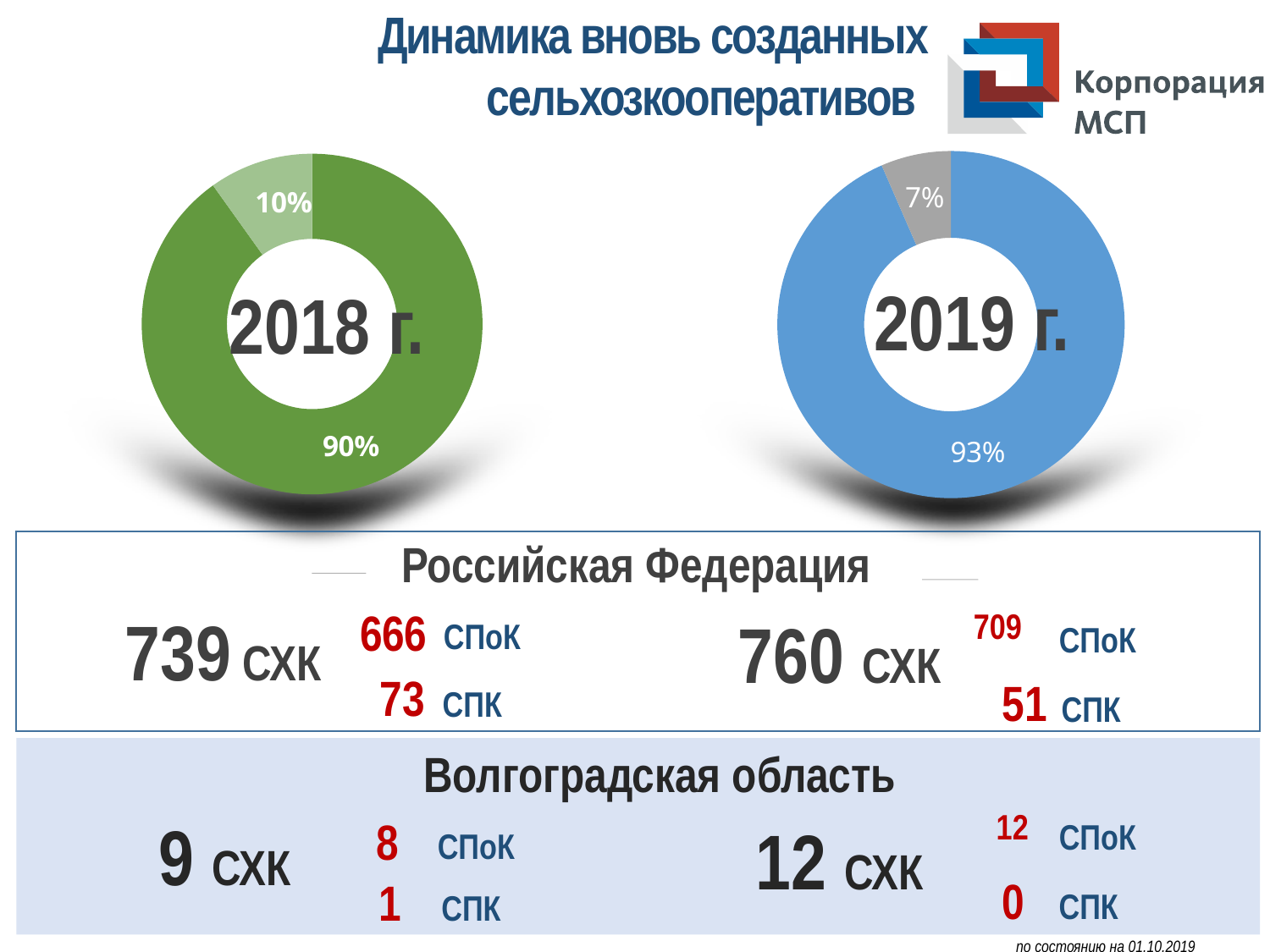
In the 2019 г. donut chart, what percentage is shown on the smaller slice? 7% How many slices does the 2019 г. donut chart have? 2 In the 2019 г. donut chart, what percentage is shown on the larger slice? 93% In the 2018 г. donut chart, what percentage is shown on the smaller slice? 10% What is the difference between the two slice values in the 2018 г. donut chart? 80% What colour is the larger slice in the 2019 г. donut chart? blue What kind of chart is used for the 2018 г. chart on the left? pie chart (donut) How many slices does the 2018 г. donut chart have? 2 What is the difference between the two slice values in the 2019 г. donut chart? 86% Which chart has the larger smaller-slice share, the 2018 г. chart or the 2019 г. chart? 2018 г. What colour is the larger slice in the 2018 г. donut chart? green In the 2018 г. donut chart, what percentage is shown on the larger slice? 90%